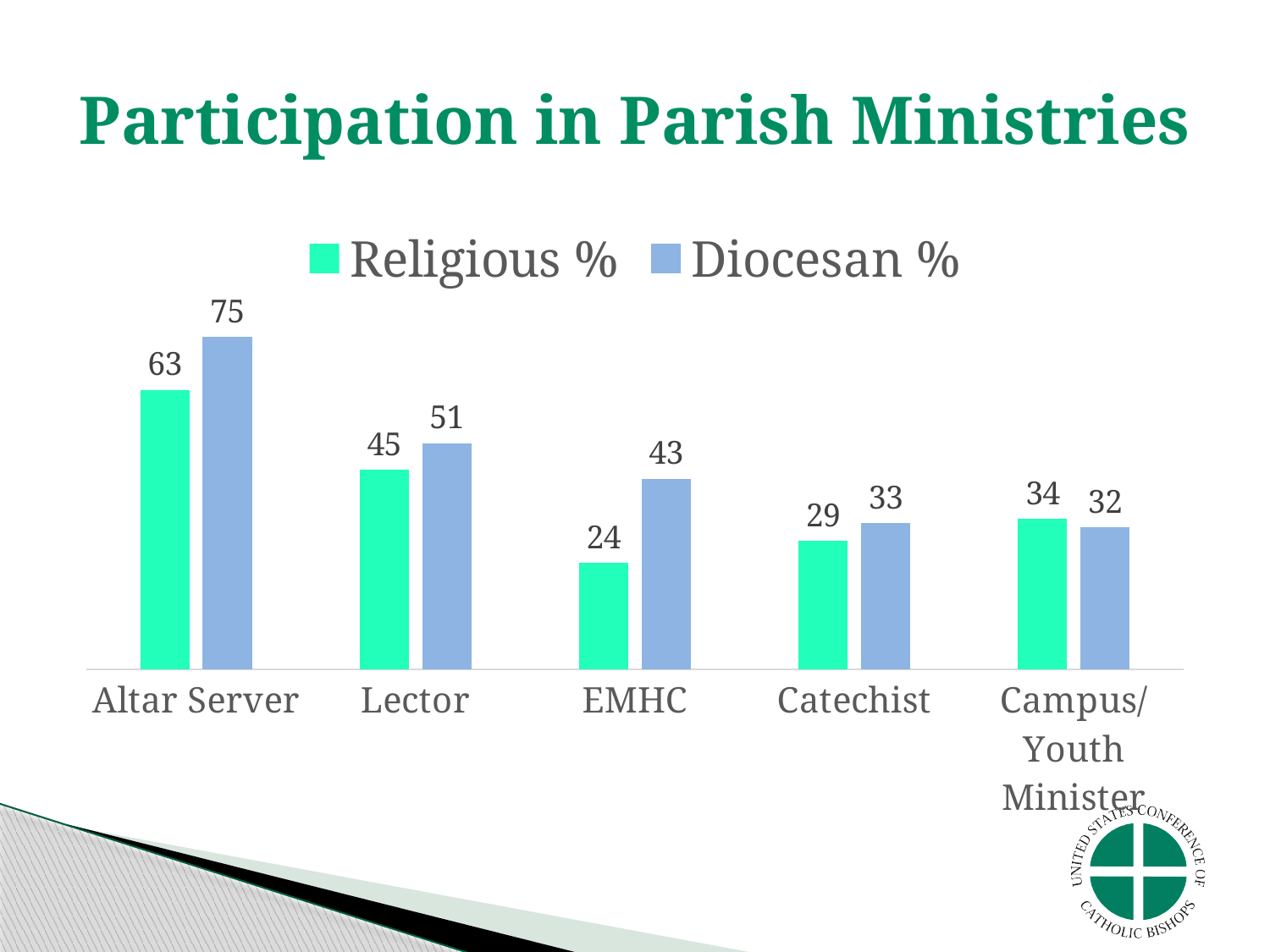
What is the Religious % value for Campus/Youth Minister? 34 What is the difference between the Diocesan % and Religious % values for Altar Server? 12 What kind of chart is shown on the slide? Bar chart What is the Religious % value for Altar Server? 63 Which category has the highest Diocesan % value? Altar Server What is the difference between the Diocesan % and Religious % values for EMHC? 19 How many series does the legend list? 2 Which category has the lowest Religious % value? EMHC What is the Diocesan % value for EMHC? 43 What is the title of the chart? Participation in Parish Ministries How many categories are shown on the x axis? 5 For Lector, which series has the larger value, Religious % or Diocesan %? Diocesan %